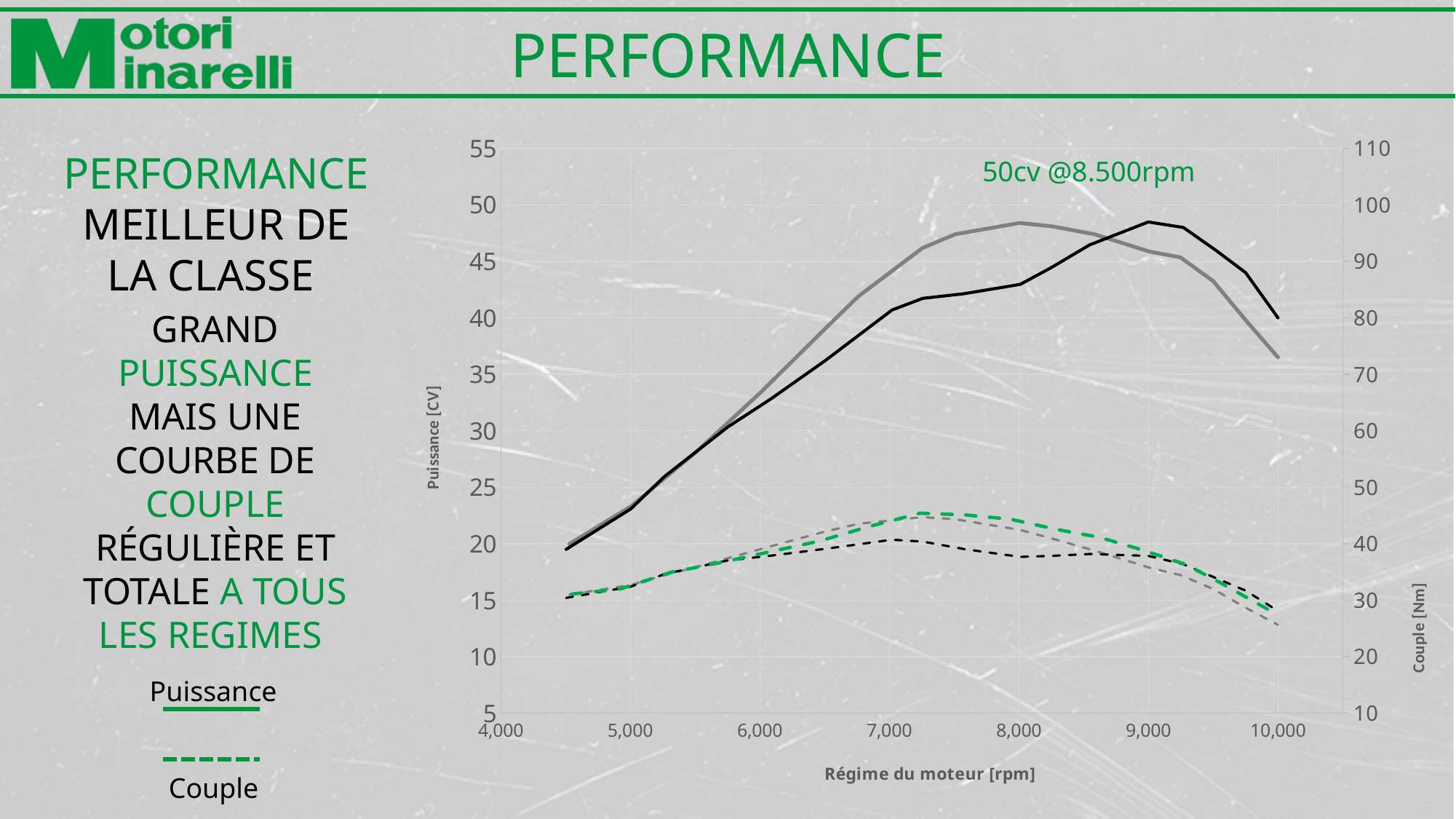
What is the title of the x axis of the chart? Régime du moteur [rpm] Does the grey solid power line rise or fall between 8,000 and 10,000 rpm? fall At 7,000 rpm, which solid power line is higher, the grey one or the black one? grey What is the title of the left y axis of the chart? Puissance [CV] Does the black solid power line rise or fall between 5,000 and 9,000 rpm? rise Is the value of the black solid power line at 5,000 rpm greater or less than 25? less What peak power annotation is printed on the chart? 50cv @8.500rpm How many rpm tick labels are shown on the x axis? 7 Is the value of the grey solid power line at 10,000 rpm greater or less than 40? less Is the value of the black solid power line at 9,000 rpm greater or less than 45? greater What kind of chart is shown on the slide? line chart